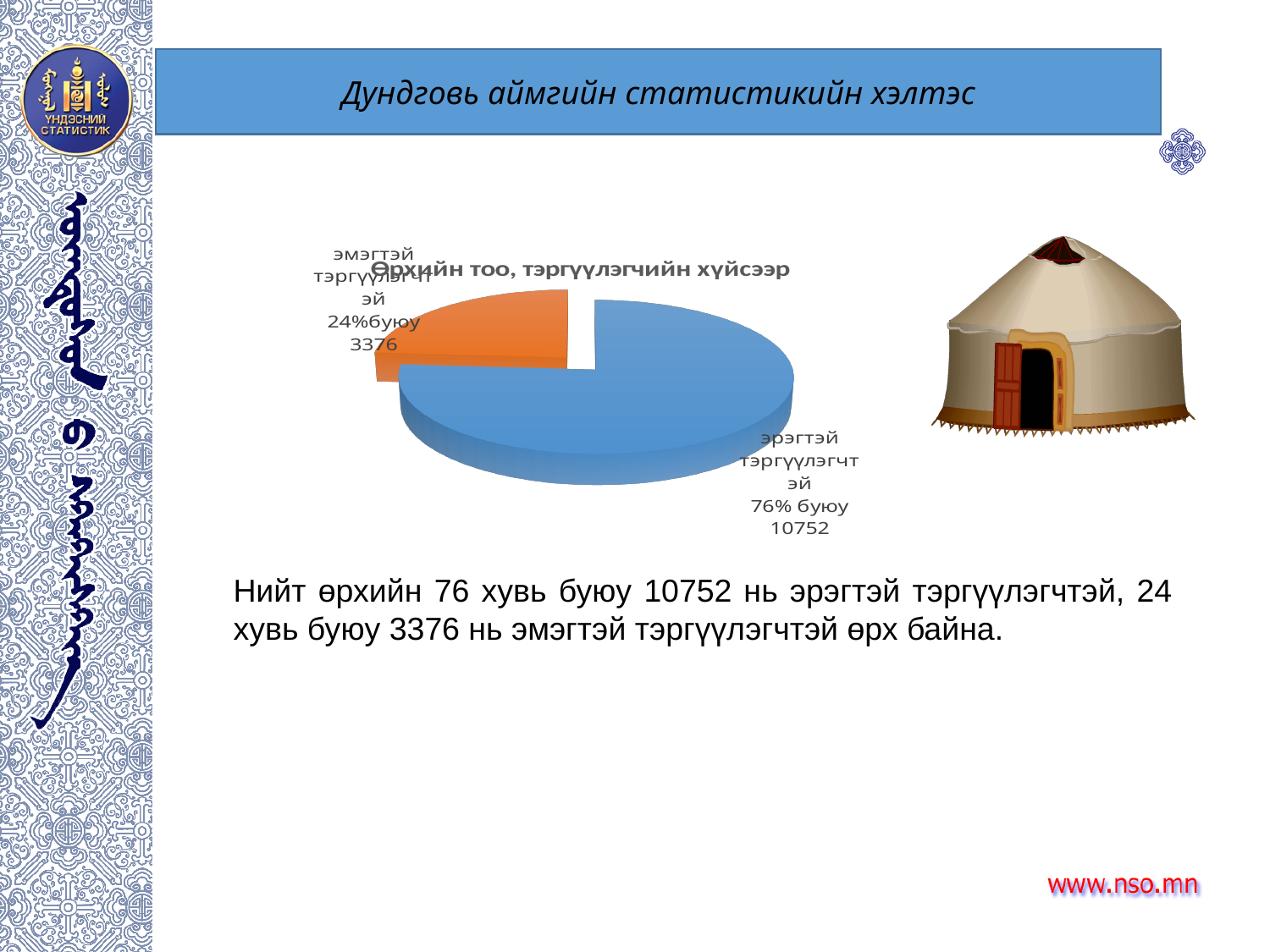
What is the title of the pie chart? Өрхийн тоо, тэргүүлэгчийн хүйсээр What is the number of households with a female head ('эмэгтэй тэргүүлэгчтэй') shown on the chart? 3376 What is the difference between the number of male-headed households (10752) and female-headed households (3376)? 7376 How many slices does the pie chart have? 2 Which is larger: the 'эрэгтэй тэргүүлэгчтэй' slice or the 'эмэгтэй тэргүүлэгчтэй' slice? эрэгтэй тэргүүлэгчтэй Which slice of the pie chart is the smallest? эмэгтэй тэргүүлэгчтэй What is the number of households with a male head ('эрэгтэй тэргүүлэгчтэй') shown on the chart? 10752 What colour is the 'эмэгтэй тэргүүлэгчтэй' slice of the pie chart? orange What kind of chart is shown on the slide? pie chart What share of the pie does the 'эмэгтэй тэргүүлэгчтэй' slice represent? 24% What share of the pie does the 'эрэгтэй тэргүүлэгчтэй' slice represent? 76% Which slice of the pie chart is the largest? эрэгтэй тэргүүлэгчтэй